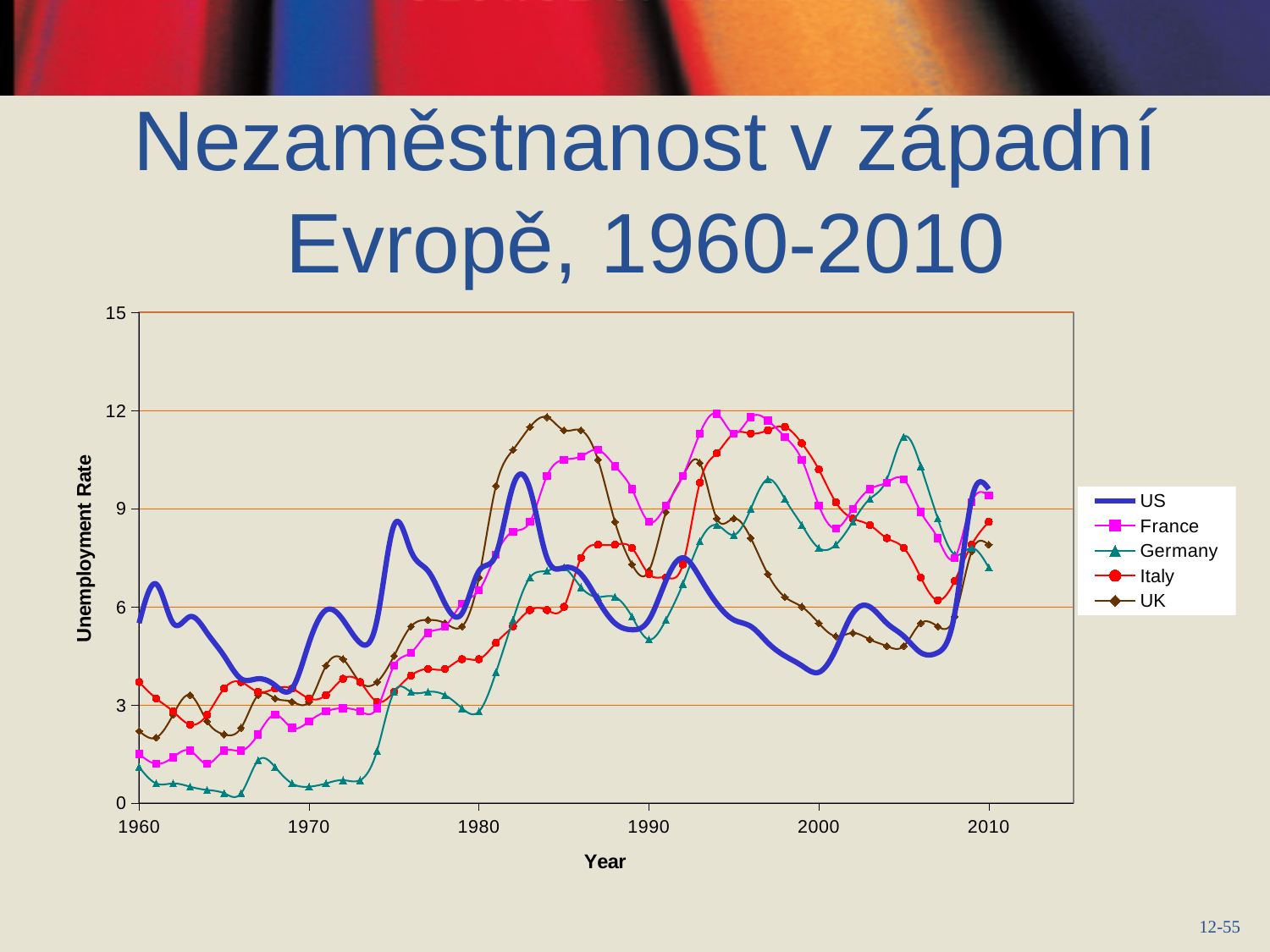
Does the France series generally rise or fall between 1960 and 1994? rise What is the label of the vertical axis? Unemployment Rate In 1960, which is higher, Italy or Germany? Italy In 2005, which is higher, Germany or US? Germany What kind of chart is shown on the slide? line chart Is the value for France in 1994 greater or less than 9? greater Is the value for UK in 1984 greater or less than 9? greater How many series does the legend list? 5 Is the value for France in 1960 greater or less than 3? less Which series is drawn with the thick blue line? US Which series has the lowest value in 1970? Germany